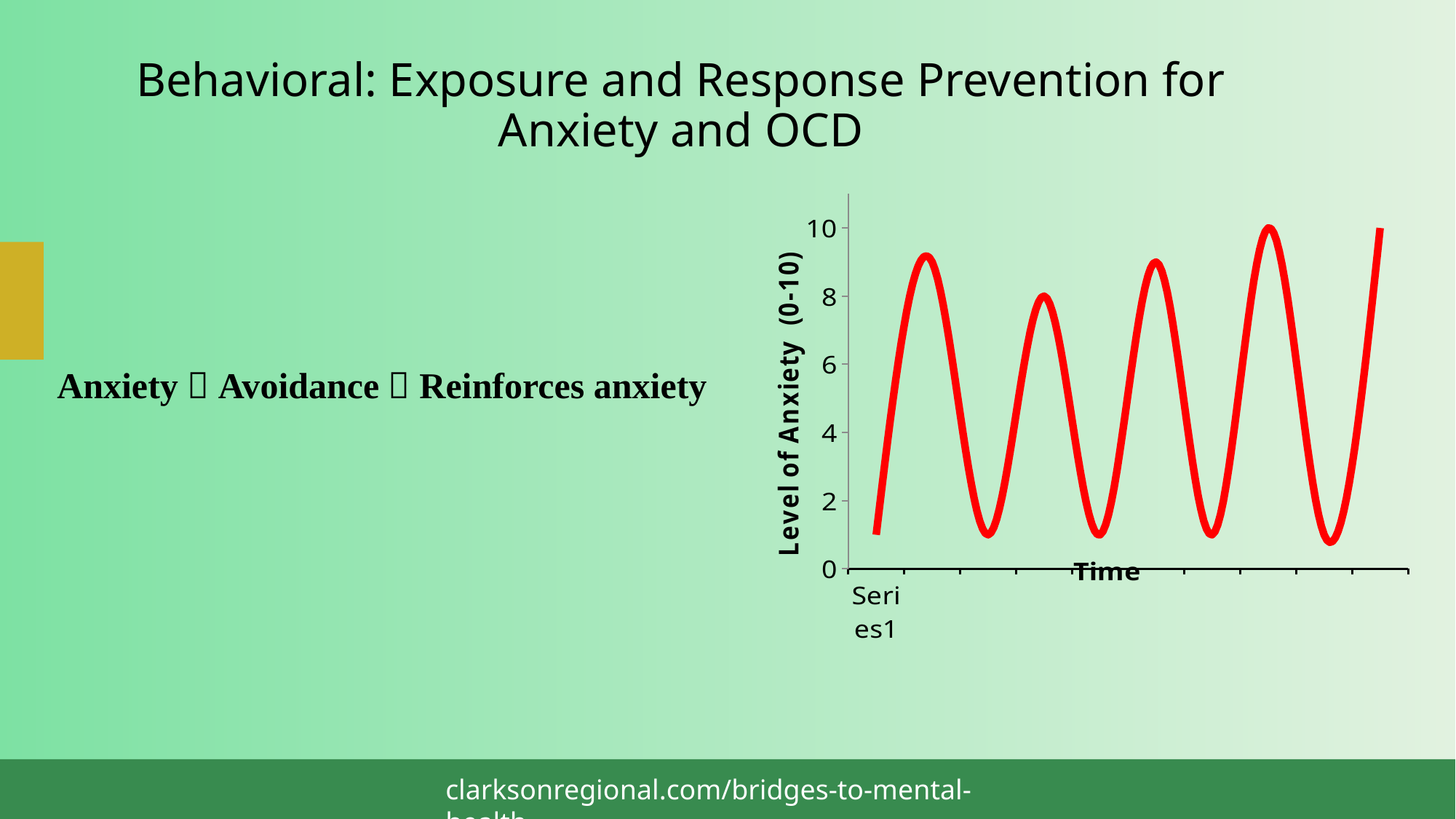
Is the first peak of the line greater or less than 8? greater Which is higher, the fourth peak or the second peak of the line? the fourth peak Is the lowest trough of the line greater or less than 2? less How many peaks does the red line reach before it starts rising again at the right edge? 4 Is the value at the very start of the line greater or less than 2? less What is the label of the vertical axis of the chart? Level of Anxiety (0-10) How many series does the chart plot? 1 Do the values steadily rise, steadily fall, or repeatedly rise and fall along the time axis? repeatedly rise and fall What is the highest tick value shown on the vertical axis? 10 What is the label of the horizontal axis of the chart? Time What kind of chart is shown on the slide? line chart